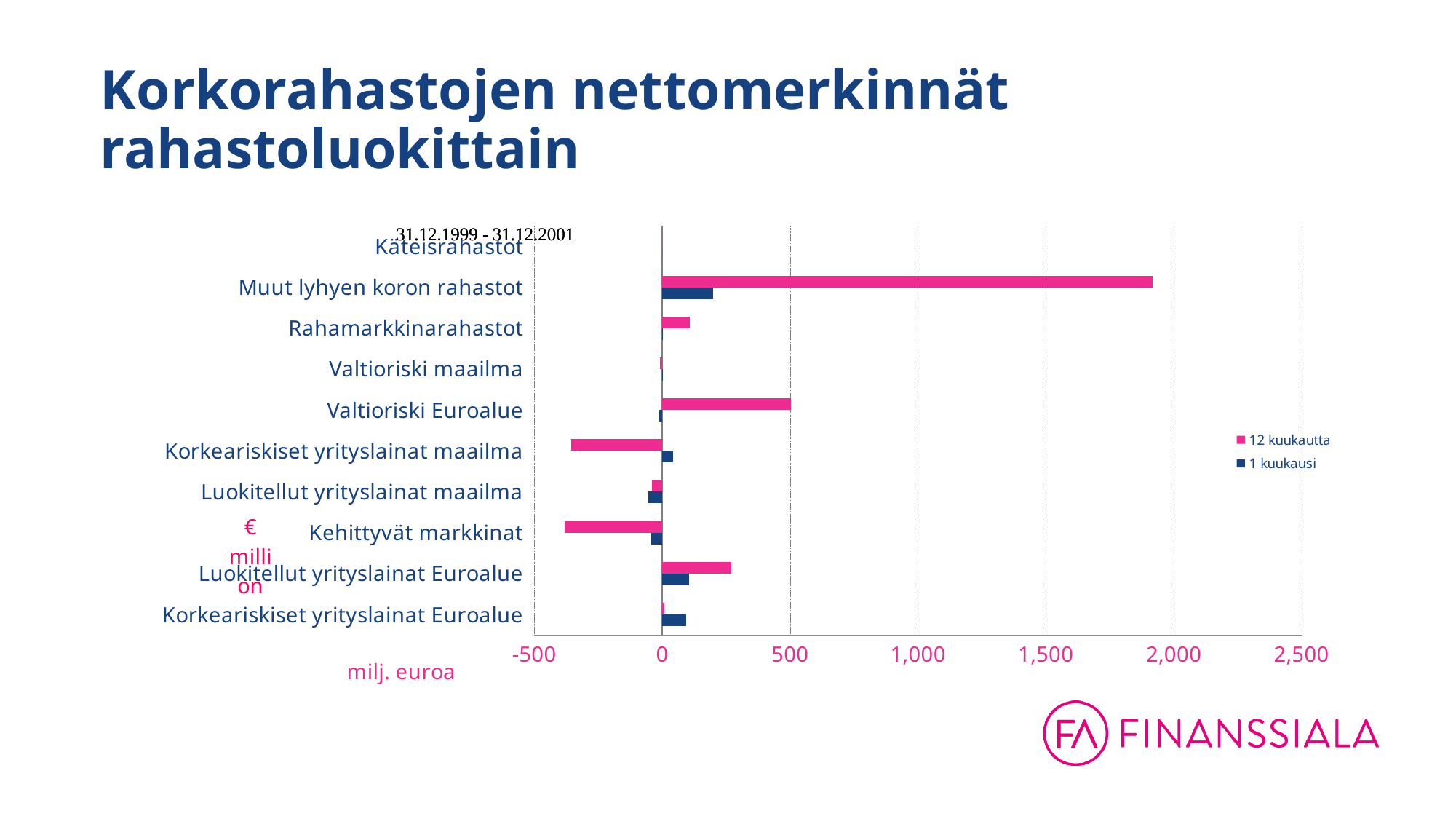
Is the 12 kuukautta value for Luokitellut yrityslainat Euroalue greater or less than 500? less What are the two series named in the legend? 12 kuukautta and 1 kuukausi Which is larger for the 12 kuukautta series: Muut lyhyen koron rahastot or Valtioriski Euroalue? Muut lyhyen koron rahastot How many fund categories are listed on the vertical axis? 10 Is the 12 kuukautta value for Kehittyvät markkinat greater or less than 0? less Which category has the highest value for the 12 kuukautta series? Muut lyhyen koron rahastot How many series does the legend list? 2 Which category has the highest value for the 1 kuukausi series? Muut lyhyen koron rahastot Is the 12 kuukautta value for Muut lyhyen koron rahastot greater or less than 1,500? greater What unit is shown below the horizontal axis? milj. euroa What kind of chart is shown on the slide? bar chart